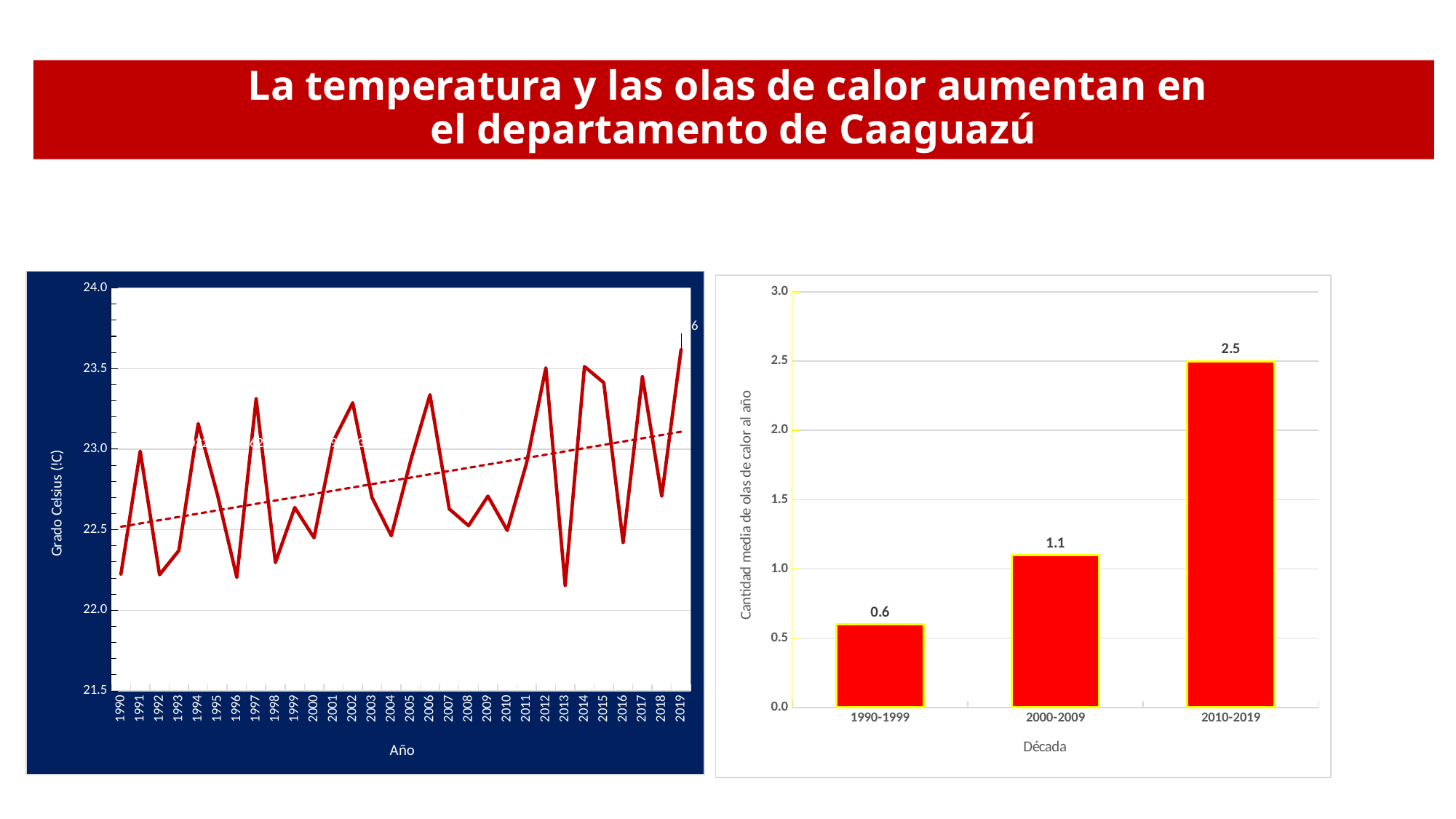
In the left-hand line chart, does the dashed trend line rise or fall from 1990 to 2019? Rises What kind of chart is the chart on the right of the slide? Bar chart In the right-hand bar chart, which decade has the highest average number of heat waves per year? 2010-2019 What kind of chart is the chart on the left of the slide? Line chart In the right-hand bar chart, what is the value for 2000-2009? 1.1 In the right-hand bar chart, what is the difference between the values for 2010-2019 and 2000-2009? 1.4 In the right-hand bar chart, how many decades are shown on the x axis? 3 In the right-hand bar chart, what is the value for 1990-1999? 0.6 In the right-hand bar chart, what is the difference between the values for 2010-2019 and 1990-1999? 1.9 In the right-hand bar chart, which decade has the lowest value? 1990-1999 In the left-hand line chart, is the value for 2013 greater or less than 22.5? less In the right-hand bar chart, what is the average number of heat waves per year for the decade 2010-2019? 2.5